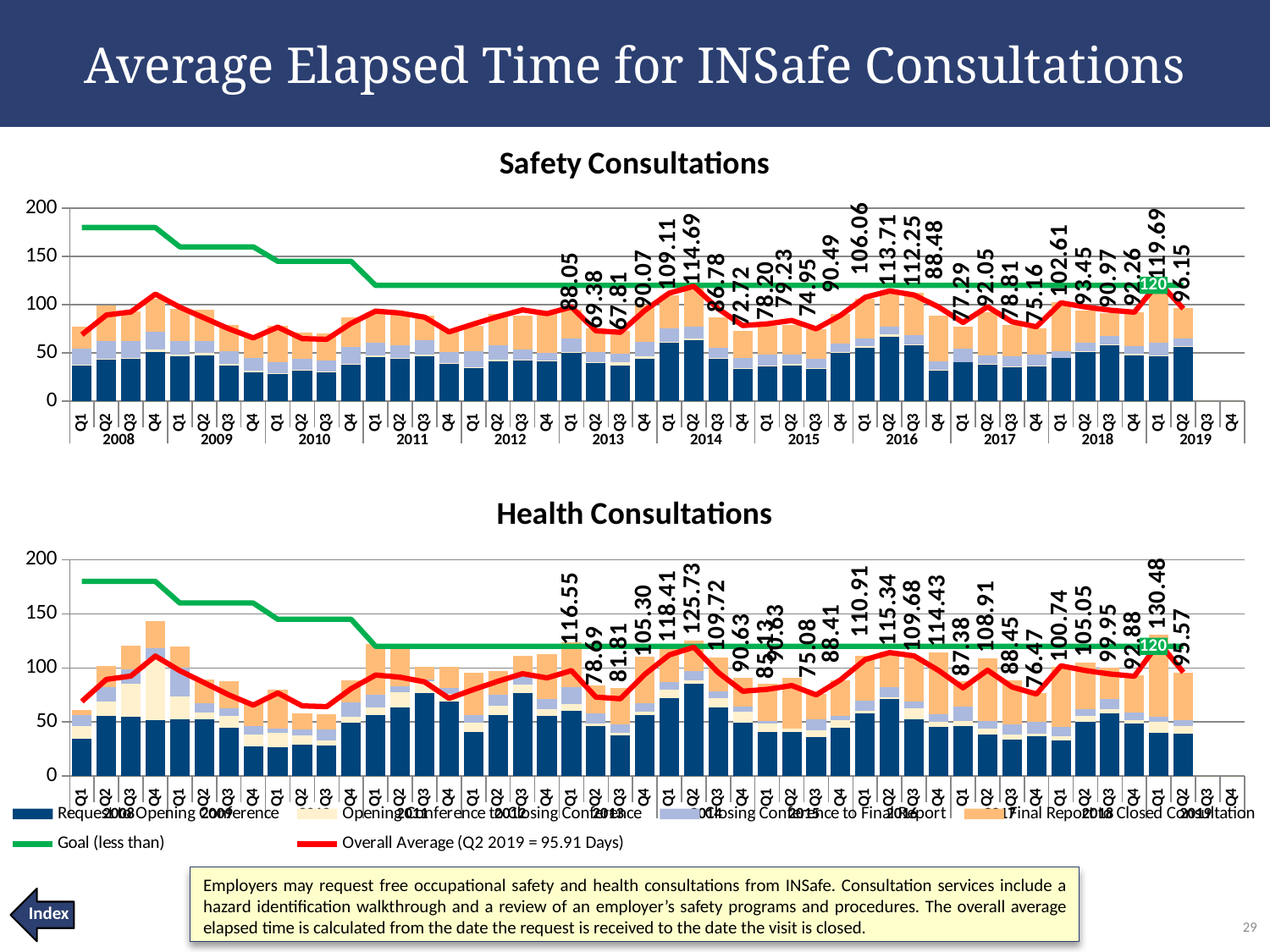
On the Safety Consultations chart, among the labeled overall average values from 2013 onward, which quarter has the lowest value? Q3 2013 On the Safety Consultations chart, is the labeled overall average for Q2 2014 greater or less than 100? greater What type of chart is the Safety Consultations chart? Stacked bar chart with line overlays What value is labeled on the goal line at Q1 2019 on both charts? 120 On the Health Consultations chart, among the labeled overall average values from 2013 onward, which quarter has the highest value? Q1 2019 On the Health Consultations chart, which is larger, the labeled overall average for Q1 2019 or Q2 2019? Q1 2019 According to the legend, what is the overall average for Q2 2019? 95.91 Days